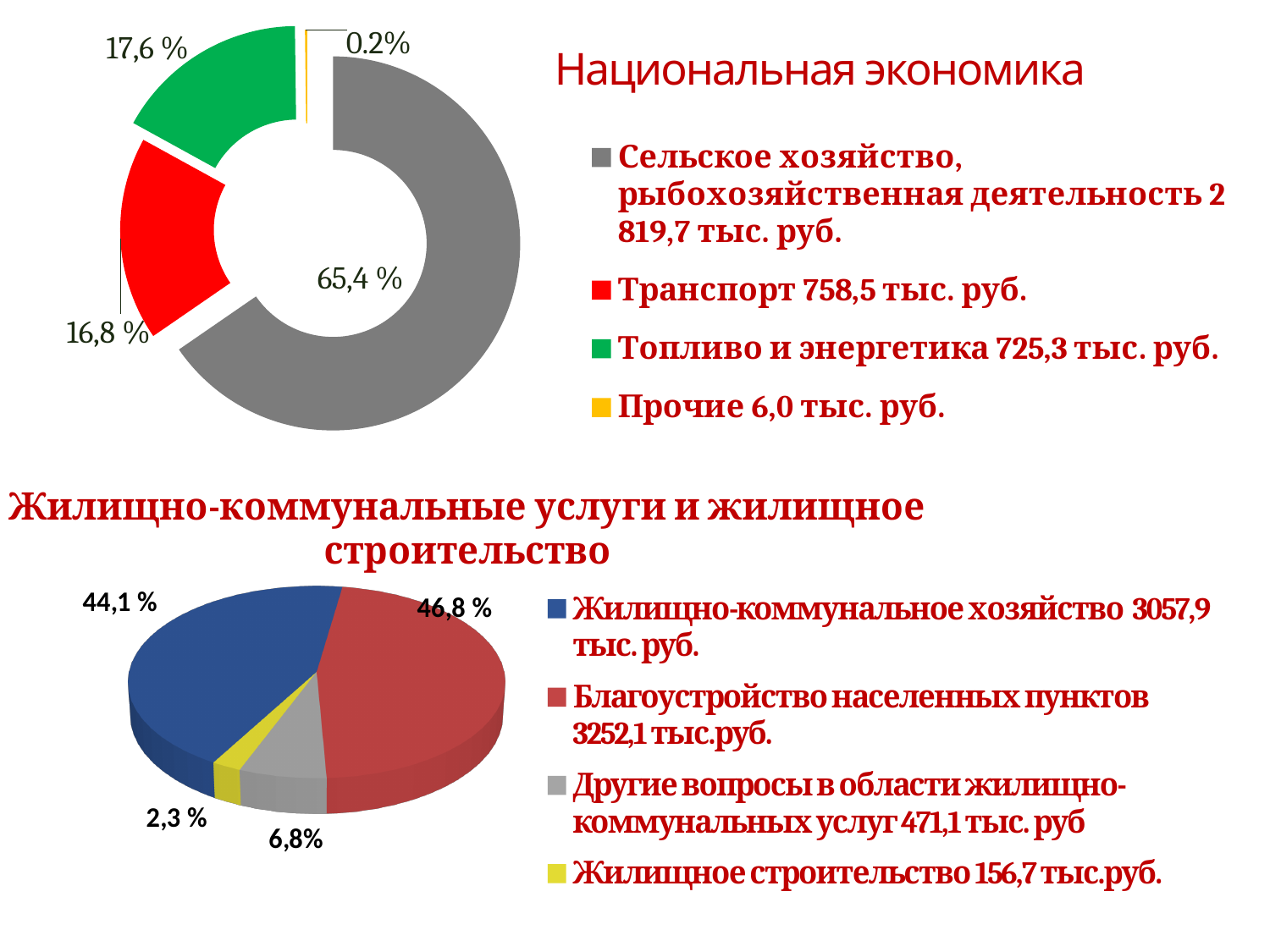
In the 'Национальная экономика' chart, which category has the smallest share? Прочие In the 'Национальная экономика' chart, what amount in тыс. руб. does the legend give for Топливо и энергетика? 725,3 тыс. руб. In the 'Национальная экономика' chart, what share is shown for Топливо и энергетика? 17,6 % In the 'Национальная экономика' chart, what share is shown for Транспорт? 16,8 % In the 'Жилищно-коммунальные услуги и жилищное строительство' chart, what is the difference in percentage points between the shares of Благоустройство населенных пунктов and Жилищно-коммунальное хозяйство? 2,7 In the 'Жилищно-коммунальные услуги и жилищное строительство' chart, which category has the largest share? Благоустройство населенных пунктов In the 'Жилищно-коммунальные услуги и жилищное строительство' chart, what share is shown for Жилищное строительство? 2,3 % In the 'Жилищно-коммунальные услуги и жилищное строительство' chart, what amount in тыс. руб. does the legend give for Другие вопросы в области жилищно-коммунальных услуг? 471,1 тыс. руб In the 'Национальная экономика' chart, which category has the largest share? Сельское хозяйство, рыбохозяйственная деятельность In the 'Национальная экономика' chart, how many categories does the legend list? 4 In the 'Жилищно-коммунальные услуги и жилищное строительство' chart, what colour is the slice for Жилищно-коммунальное хозяйство? Blue What kind of chart is the 'Национальная экономика' chart? Doughnut chart